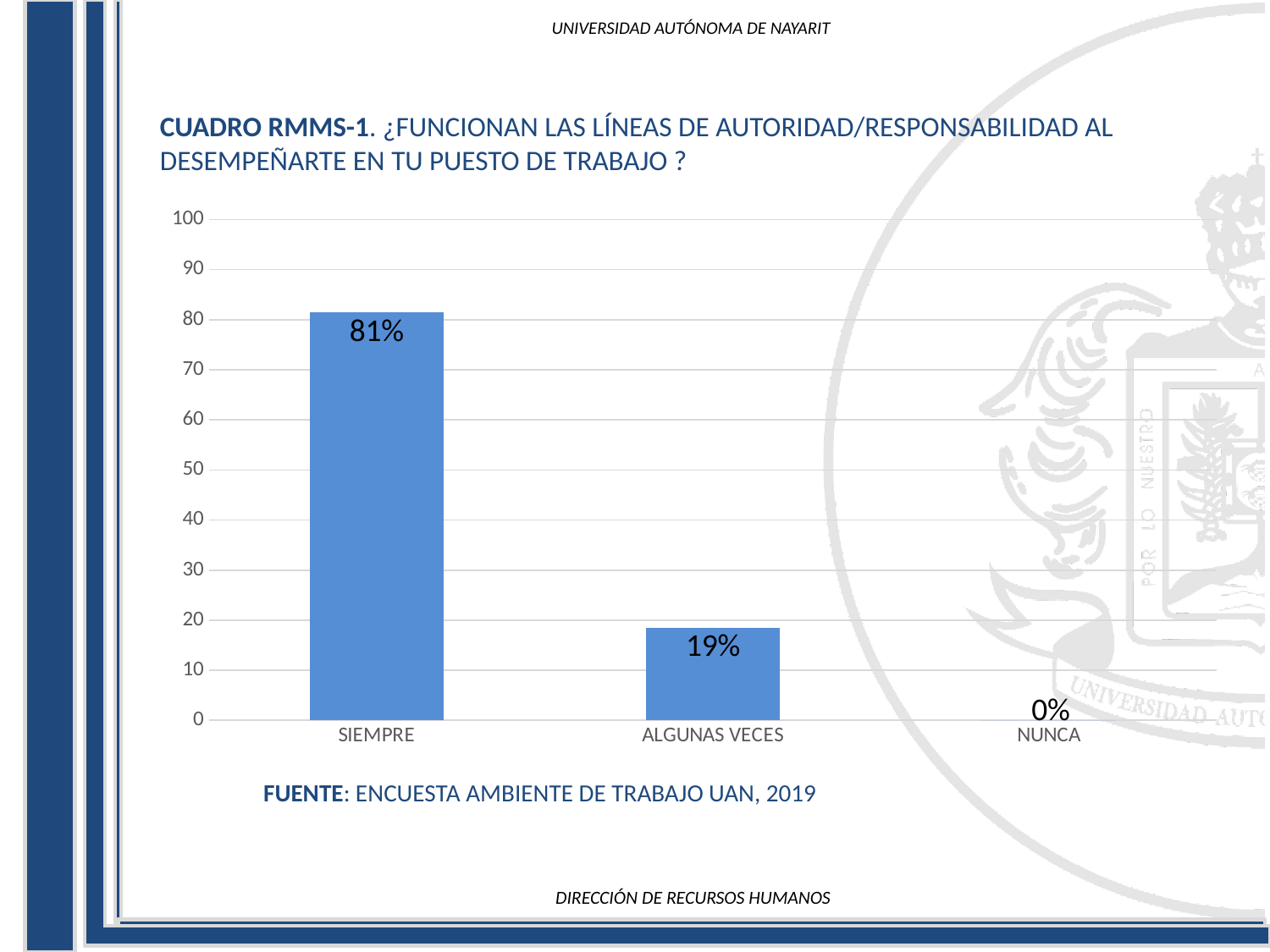
Which category has the lowest value? NUNCA What kind of chart is shown on the slide? bar chart Do the values rise or fall from left to right along the x axis? fall What is the difference between the values for SIEMPRE and ALGUNAS VECES? 62% Which is larger, the value for ALGUNAS VECES or the value for NUNCA? ALGUNAS VECES Which category has the highest value? SIEMPRE What is the value for ALGUNAS VECES? 19% What is the value for SIEMPRE? 81% What source is cited below the chart? ENCUESTA AMBIENTE DE TRABAJO UAN, 2019 Is the value for SIEMPRE greater or less than 70? greater What is the value for NUNCA? 0% How many categories are shown on the x axis? 3